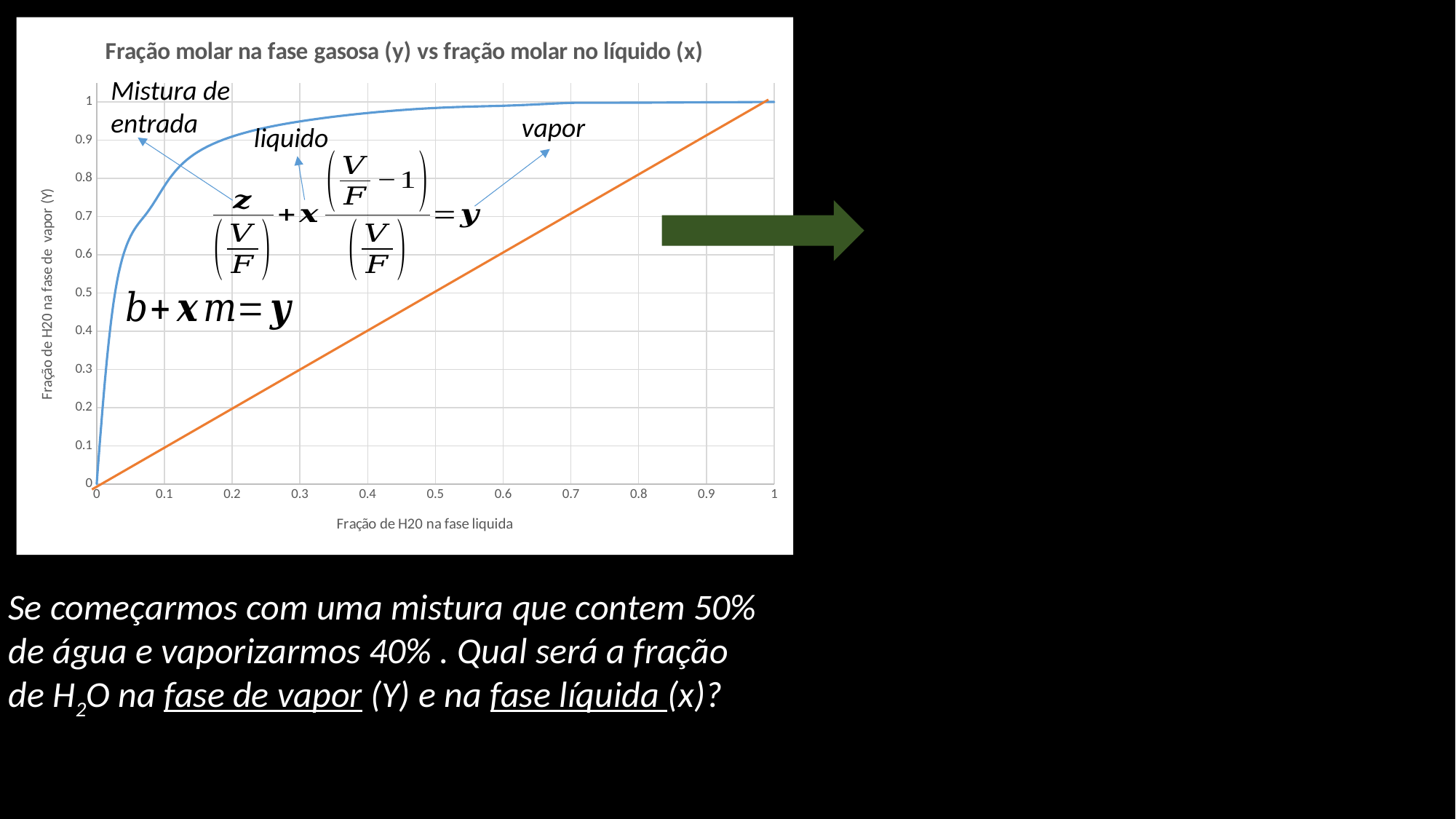
What kind of chart is shown on the slide? line chart What is the highest value shown on the y axis of the chart? 1 How many lines are plotted on the chart? 2 At x = 0.3, which line has the higher value, the blue curve or the orange line? the blue curve What is the title of the chart? Fração molar na fase gasosa (y) vs fração molar no líquido (x) Is the value of the blue curve at x = 0.5 greater or less than 0.9? greater Is the value of the orange line at x = 0.2 greater or less than 0.3? less Is the value of the blue curve at x = 0.1 greater or less than 0.7? greater What is the label of the x axis of the chart? Fração de H20 na fase liquida Does the blue curve rise or fall as x increases from 0 to 1? rise